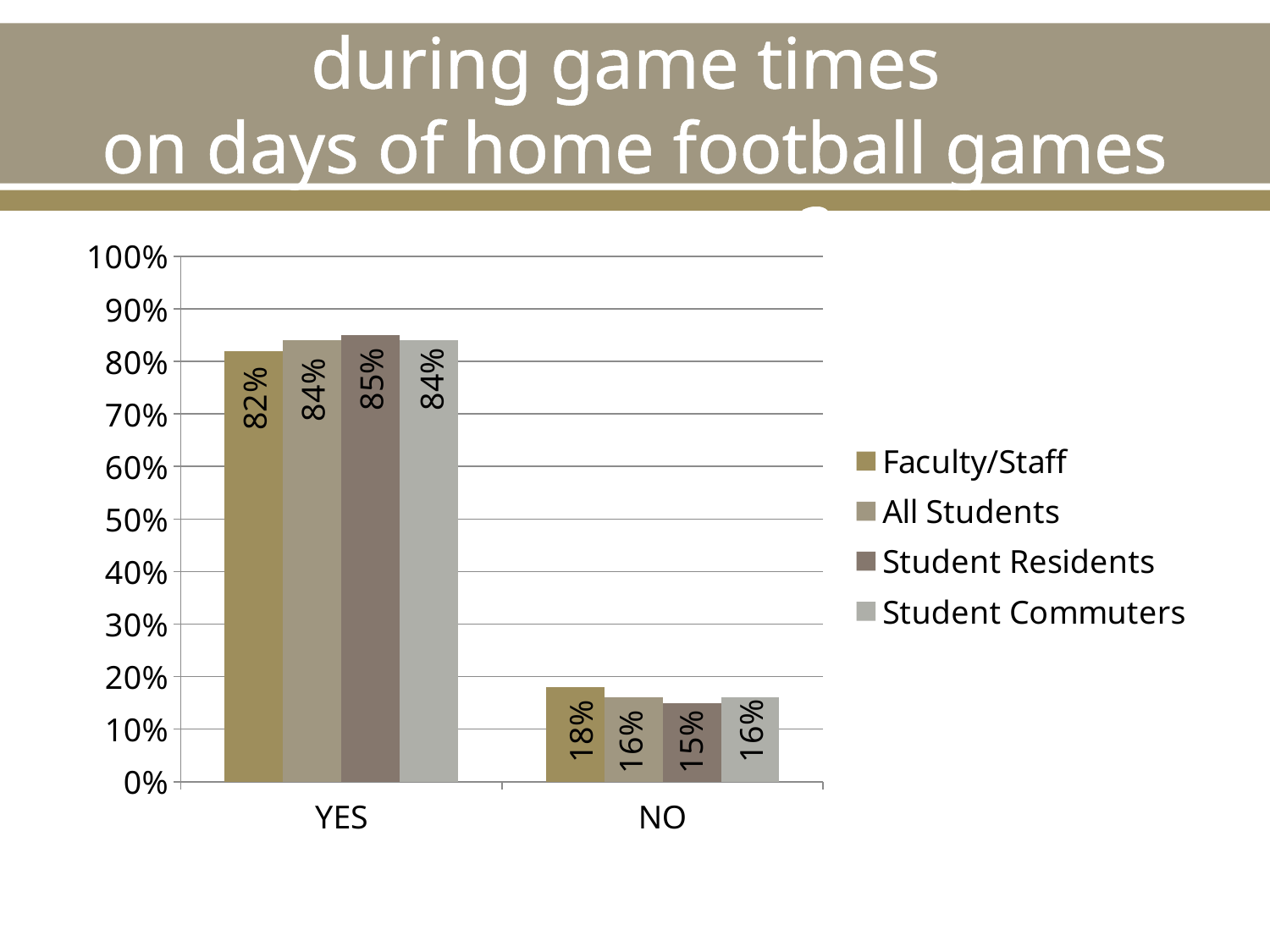
What is the difference between the Faculty/Staff values for YES and NO? 64% What is the value for Student Residents in the NO category? 15% What is the value for Student Commuters in the NO category? 16% How many series does the legend list? 4 Which is larger: the Faculty/Staff value for YES or the Student Residents value for YES? Student Residents value for YES What kind of chart is shown on the slide? Bar chart How many categories are shown on the x axis? 2 What is the difference between the Faculty/Staff and Student Residents values in the NO category? 3% What is the value for Faculty/Staff in the YES category? 82% Which series has the highest value in the YES category? Student Residents What is the value for All Students in the YES category? 84% Which series has the highest value in the NO category? Faculty/Staff